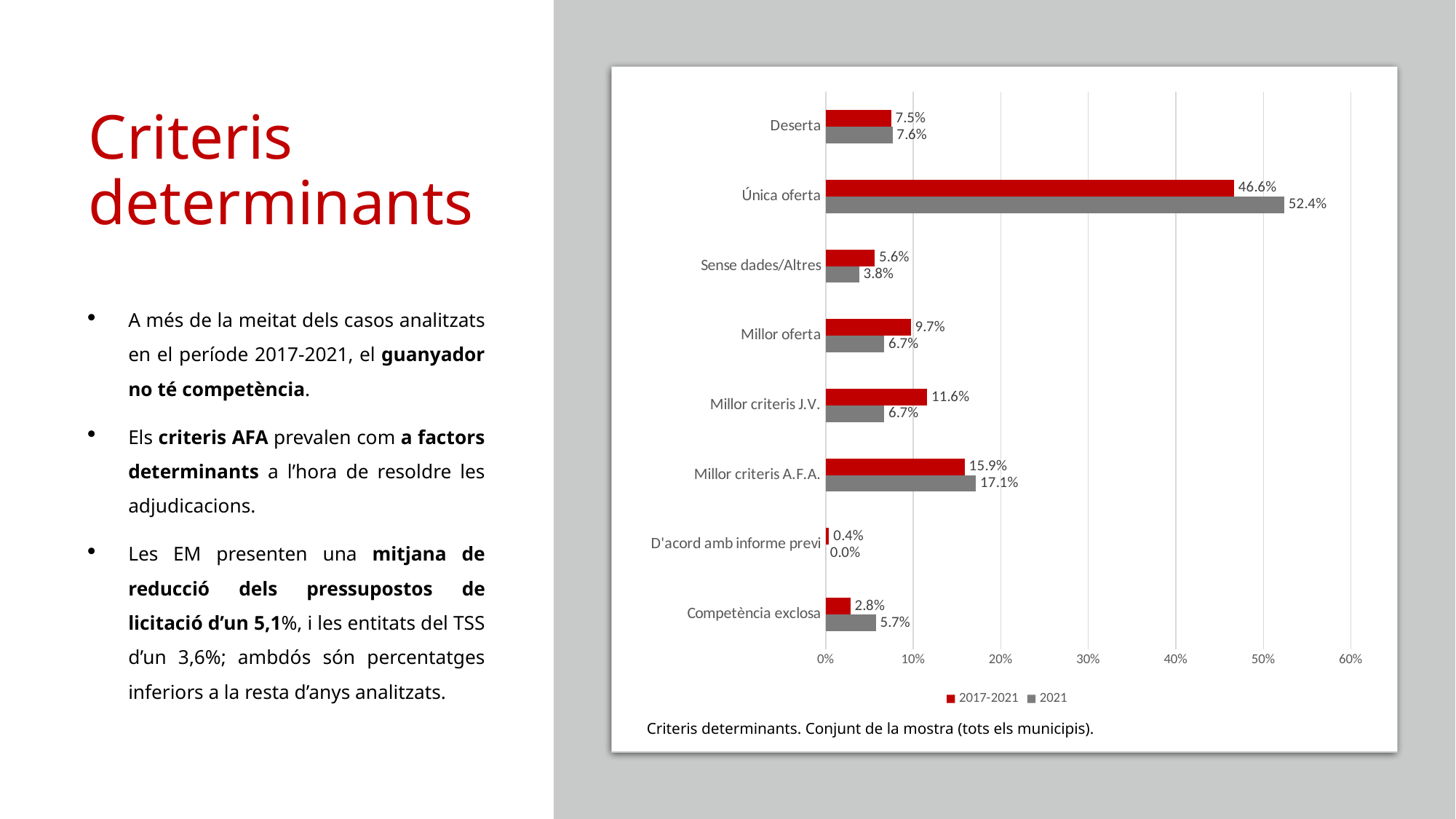
Which category has the highest value in the 2017-2021 series? Única oferta What kind of chart is shown on the slide? Bar chart How many series does the legend list? 2 How many categories are shown on the chart? 8 What is the value for D'acord amb informe previ in the 2021 series? 0.0% Which is larger for Competència exclosa: the 2017-2021 value or the 2021 value? 2021 Is the 2021 value for Única oferta greater or less than 50%? greater What is the difference between the 2021 and 2017-2021 values for Única oferta? 5.8% Which colour represents the 2017-2021 series? Red Which category has the lowest value in the 2021 series? D'acord amb informe previ What is the value for Millor criteris A.F.A. in the 2017-2021 series? 15.9% What is the value for Única oferta in the 2021 series? 52.4%